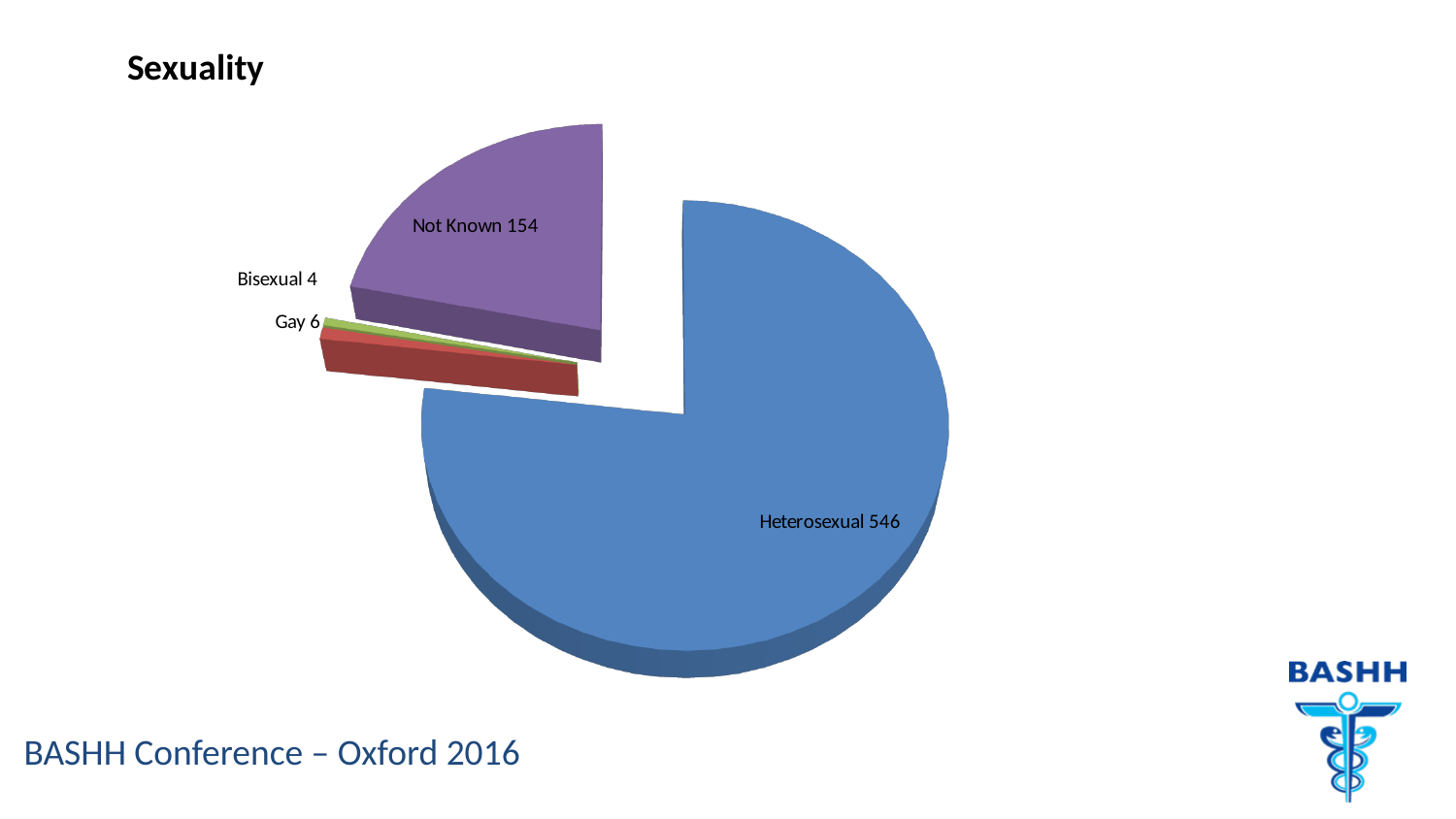
What is the title of the chart? Sexuality Which category has the smallest slice? Bisexual What is the difference between the Heterosexual and Not Known values? 392 How many slices does the pie chart have? 4 What is the total of all four slices in the pie chart? 710 What is the value for Bisexual? 4 What is the value for Heterosexual? 546 What type of chart is shown on the slide? Pie chart Which is larger, the value for Gay or the value for Bisexual? Gay Which category has the largest slice? Heterosexual What is the value for Not Known? 154 What is the value for Gay? 6